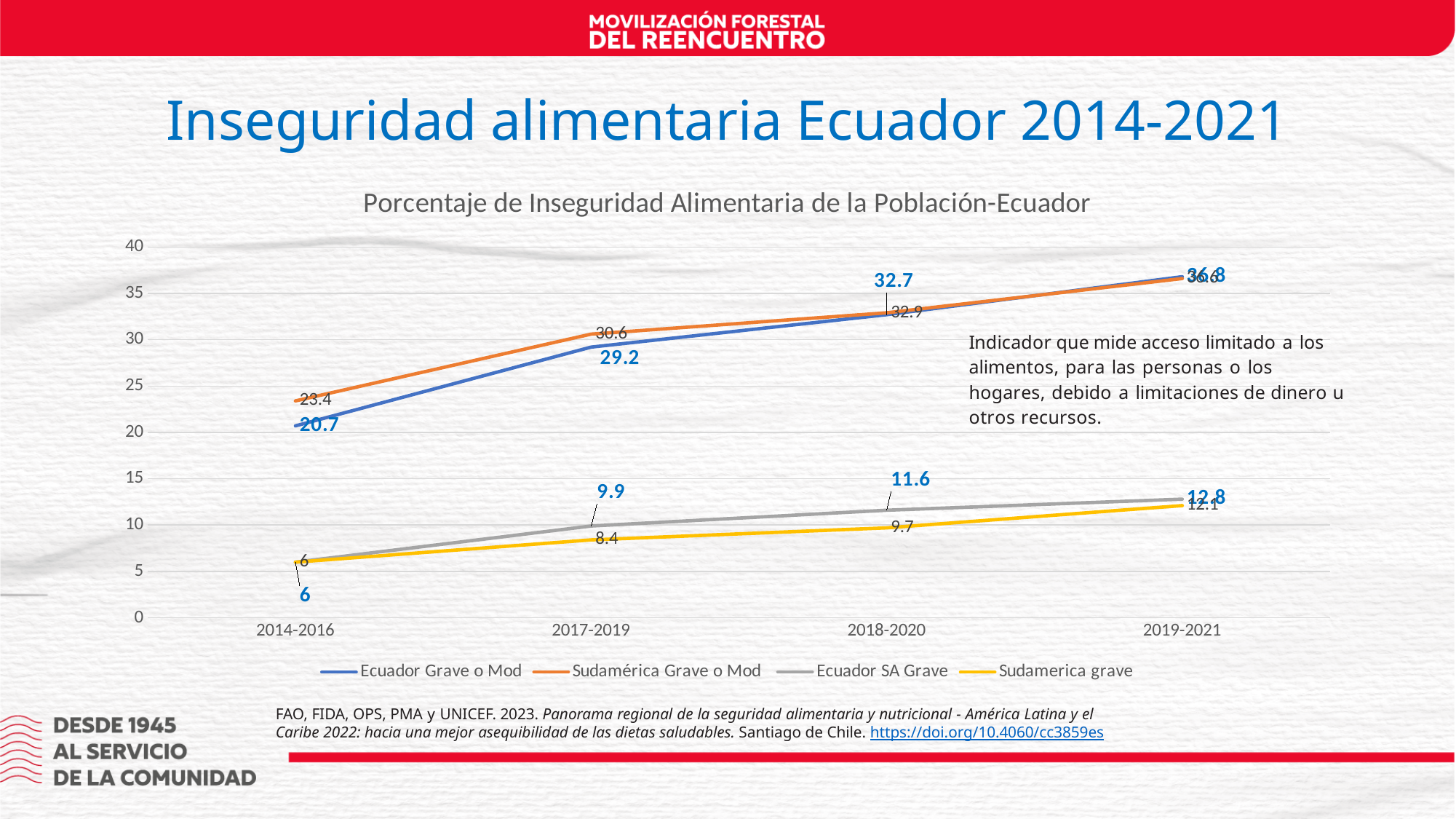
What is the value for Sudamerica grave in 2017-2019? 8.4 What is the value for Sudamérica Grave o Mod in 2017-2019? 30.6 Is the value for Ecuador Grave o Mod in 2019-2021 greater or less than 35? greater By how much did Ecuador SA Grave increase from 2014-2016 to 2019-2021? 6.8 What is the value for Ecuador SA Grave in 2018-2020? 11.6 How many periods are shown on the x axis of the chart? 4 What is the value for Ecuador Grave o Mod in 2014-2016? 20.7 Does the Ecuador Grave o Mod series rise or fall from 2014-2016 to 2019-2021? rise How many series does the chart legend list? 4 What kind of chart is shown on the slide? line chart In 2014-2016, how much higher is Sudamérica Grave o Mod than Ecuador Grave o Mod? 2.7 In 2017-2019, which is larger: Ecuador Grave o Mod or Sudamérica Grave o Mod? Sudamérica Grave o Mod